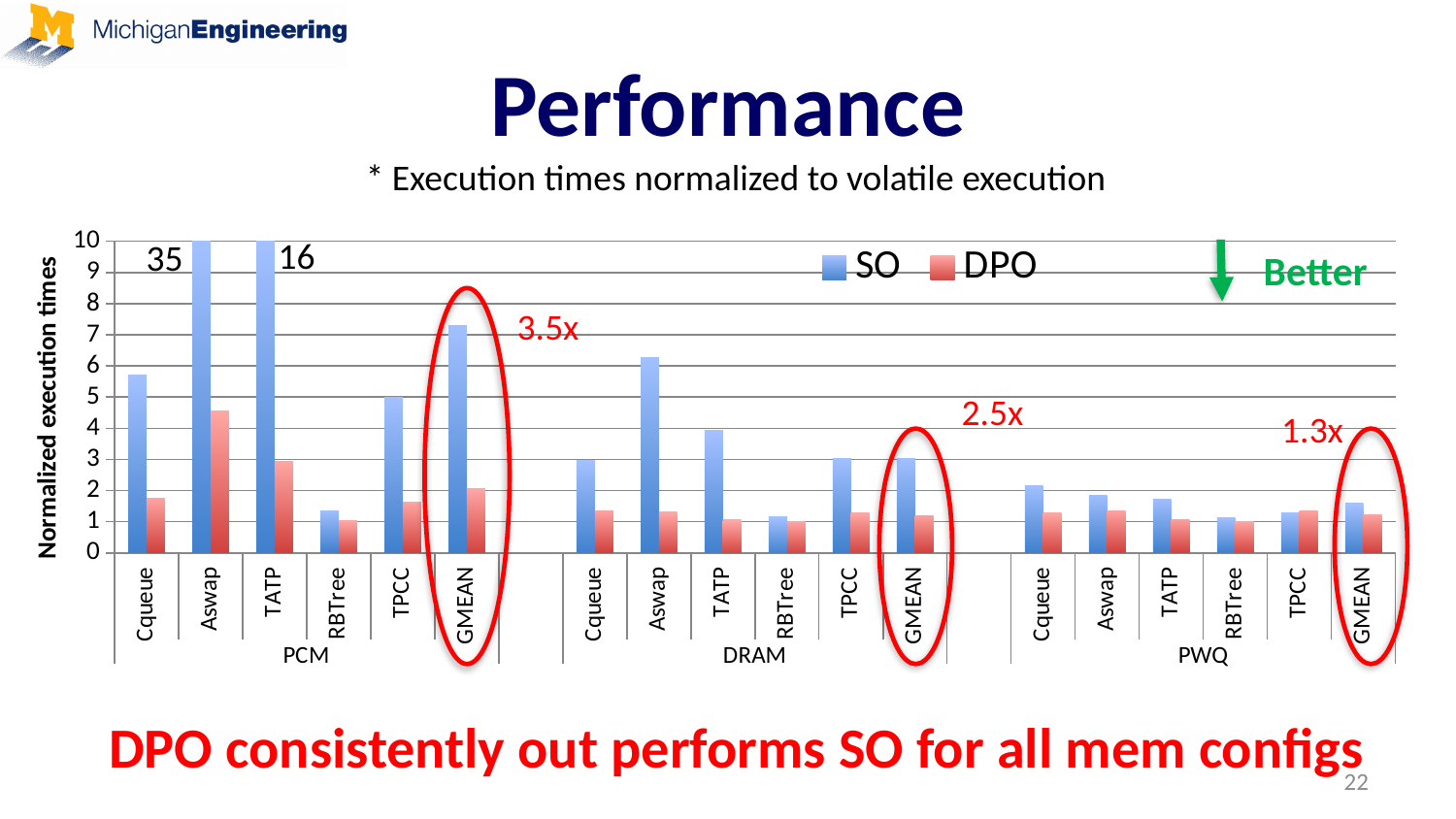
What are the two series named in the chart's legend? SO and DPO What speedup annotation is written next to the circled GMEAN bars under DRAM? 2.5x What is the SO value for Aswap under PCM? 35 How many series does the chart's legend list? 2 For TPCC under PCM, which is larger, the SO value or the DPO value? SO How many memory configuration groups (PCM, DRAM, PWQ) are shown on the x axis? 3 Within the PWQ group, which benchmark has the highest SO bar? Cqueue Is the SO value for Cqueue under PCM greater or less than 5? greater Within the PCM group, which benchmark has the lowest SO bar? RBTree What is the SO value for TATP under PCM? 16 What kind of chart is shown on the slide? bar chart Is the DPO value for Aswap under PCM greater or less than 4? greater